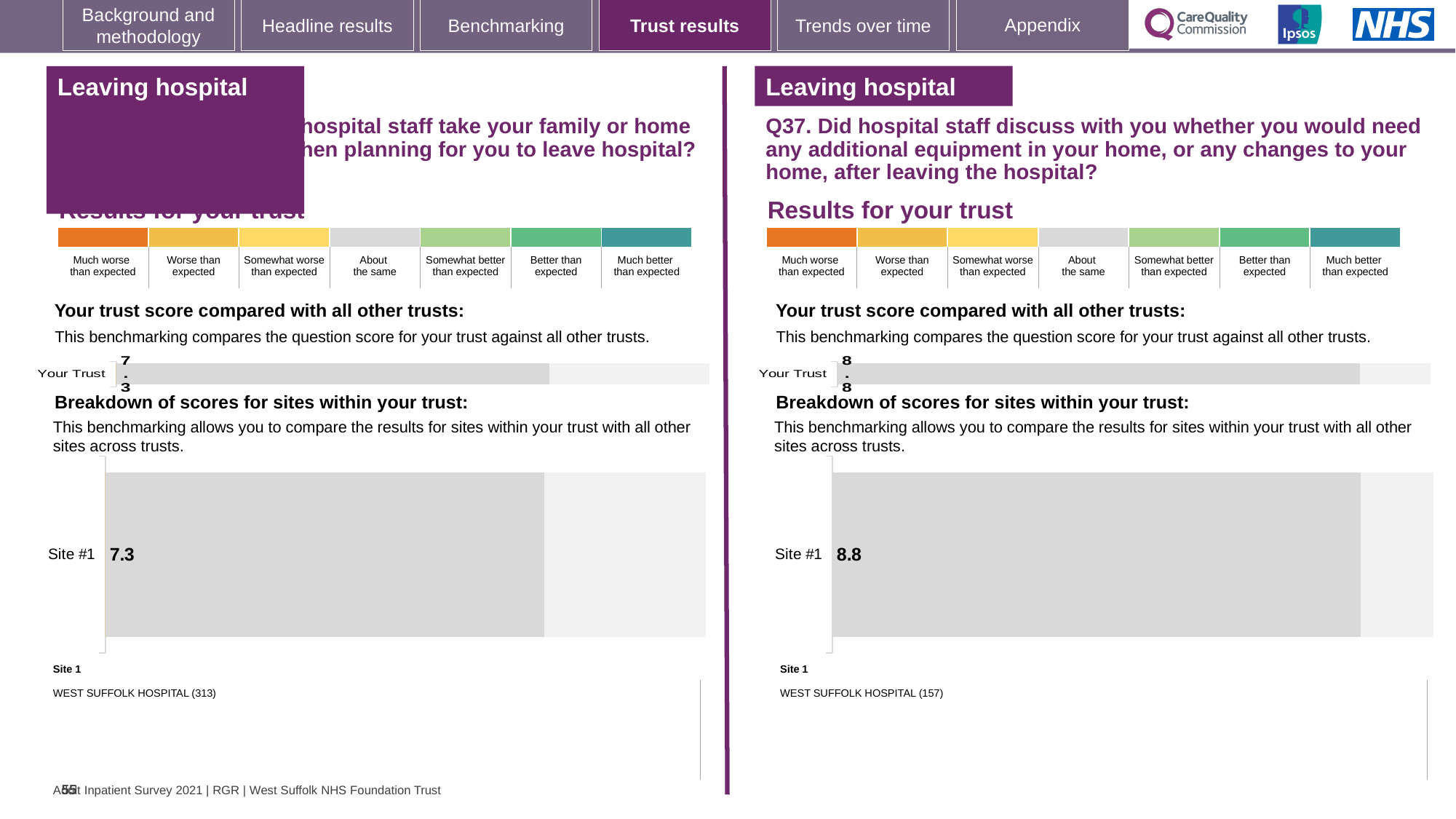
On the right-hand chart for Q37, what is the 'Your Trust' score? 8.8 On the right-hand chart for Q37, which hospital is listed as Site 1? WEST SUFFOLK HOSPITAL (157) How many sites are shown in the site breakdown chart on the left-hand side? 1 Which is larger: the Site #1 score on the left-hand chart or the Site #1 score on the right-hand chart for Q37? Right-hand chart (Q37) How many sites are shown in the site breakdown chart on the right-hand side for Q37? 1 On the left-hand chart, what is the score shown for Site #1? 7.3 What is the difference between the Site #1 score on the right-hand chart for Q37 and the Site #1 score on the left-hand chart? 1.5 On the left-hand chart, which hospital is listed as Site 1? WEST SUFFOLK HOSPITAL (313) On the left-hand chart, what is the 'Your Trust' score? 7.3 What type of chart is used for the site breakdown on the right-hand side for Q37? Bar chart On the right-hand chart for Q37, what is the score shown for Site #1? 8.8